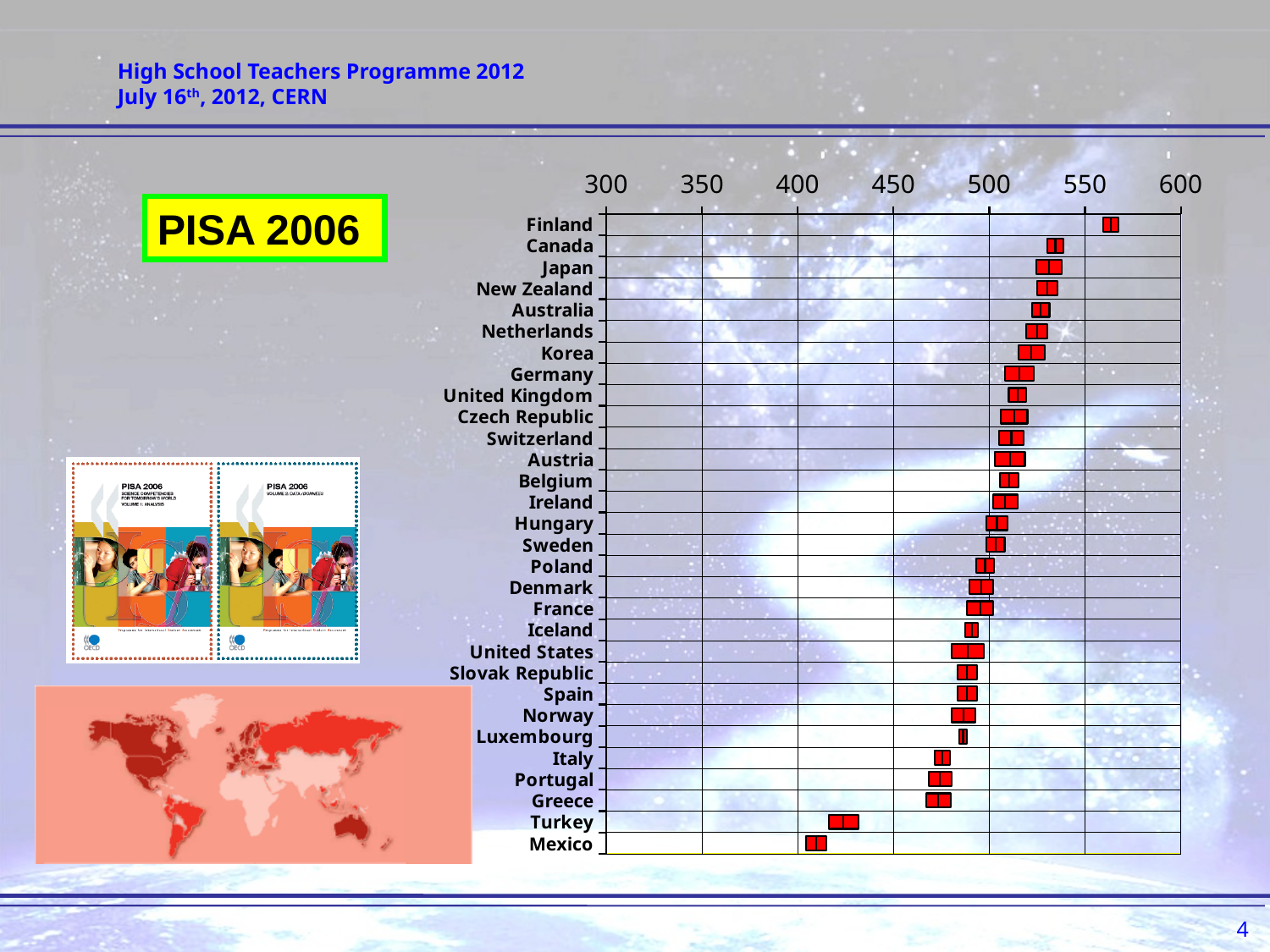
Which country has the lowest value on the PISA 2006 chart? Mexico Is the value for Greece greater or less than 500? less Is the value for Turkey greater or less than 450? less How many countries are listed on the chart? 30 Is the value for Mexico greater or less than 450? less Which country has the highest value on the PISA 2006 chart? Finland What is the lowest value shown on the horizontal axis of the chart? 300 Which has the larger value, Turkey or Mexico? Turkey Which has the larger value, Japan or Italy? Japan